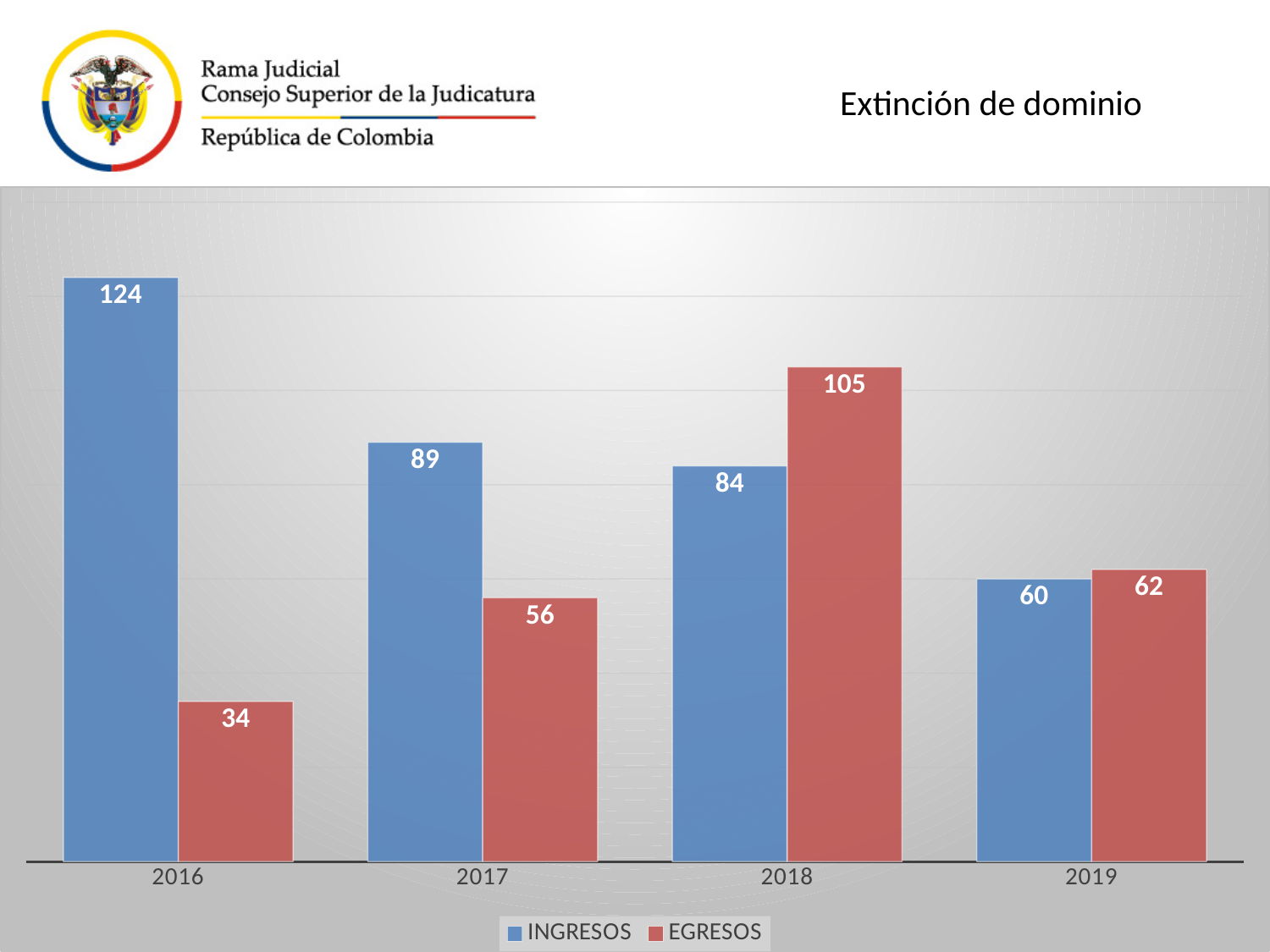
How many years are shown on the x axis? 4 Which year has the lowest EGRESOS value? 2016 In 2018, which is larger, INGRESOS or EGRESOS? EGRESOS What kind of chart is shown on the slide? Bar chart Which year has the highest INGRESOS value? 2016 Do the INGRESOS values rise or fall from 2016 to 2019? Fall How many series does the legend list? 2 What is the difference between INGRESOS and EGRESOS in 2016? 90 What is the INGRESOS value for 2016? 124 What is the difference between EGRESOS in 2018 and EGRESOS in 2017? 49 What is the EGRESOS value for 2018? 105 What is the EGRESOS value for 2017? 56